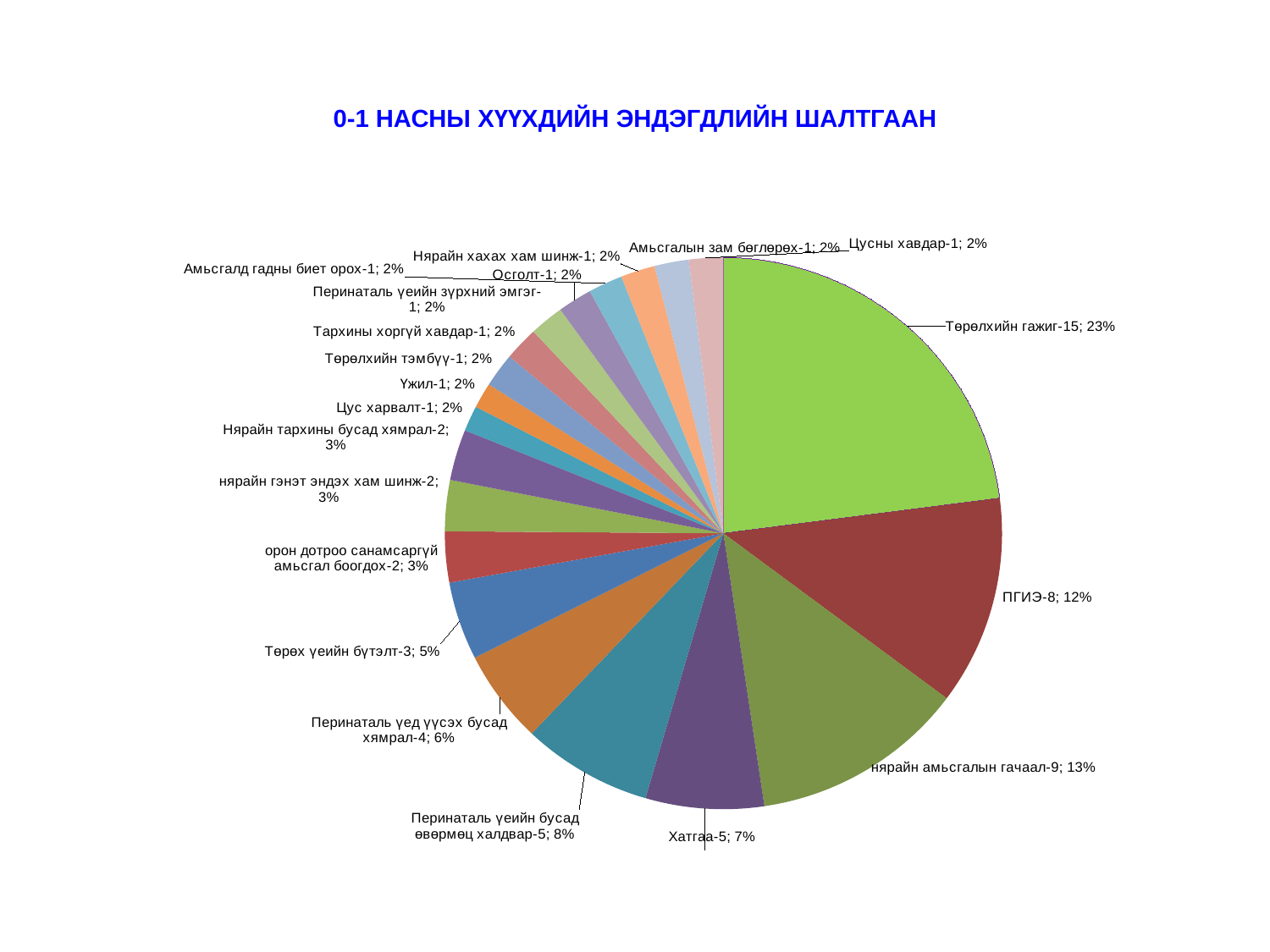
How many slices does the pie chart have? 20 What is the count shown for ПГИЭ? 8 What is the title of the chart? 0-1 НАСНЫ ХҮҮХДИЙН ЭНДЭГДЛИЙН ШАЛТГААН What kind of chart is shown on the slide? pie chart What share of the pie does Хатгаа represent? 7% What share of the pie does нярайн амьсгалын гачаал represent? 13% Which is larger, the slice for нярайн амьсгалын гачаал or the slice for ПГИЭ? нярайн амьсгалын гачаал What share of the pie does Төрөлхийн гажиг represent? 23% What is the count shown for Перинаталь үед үүсэх бусад хямрал? 4 Which category has the largest slice of the pie? Төрөлхийн гажиг What is the count shown for Төрөх үеийн бүтэлт? 3 What is the difference in count between Төрөлхийн гажиг and ПГИЭ? 7